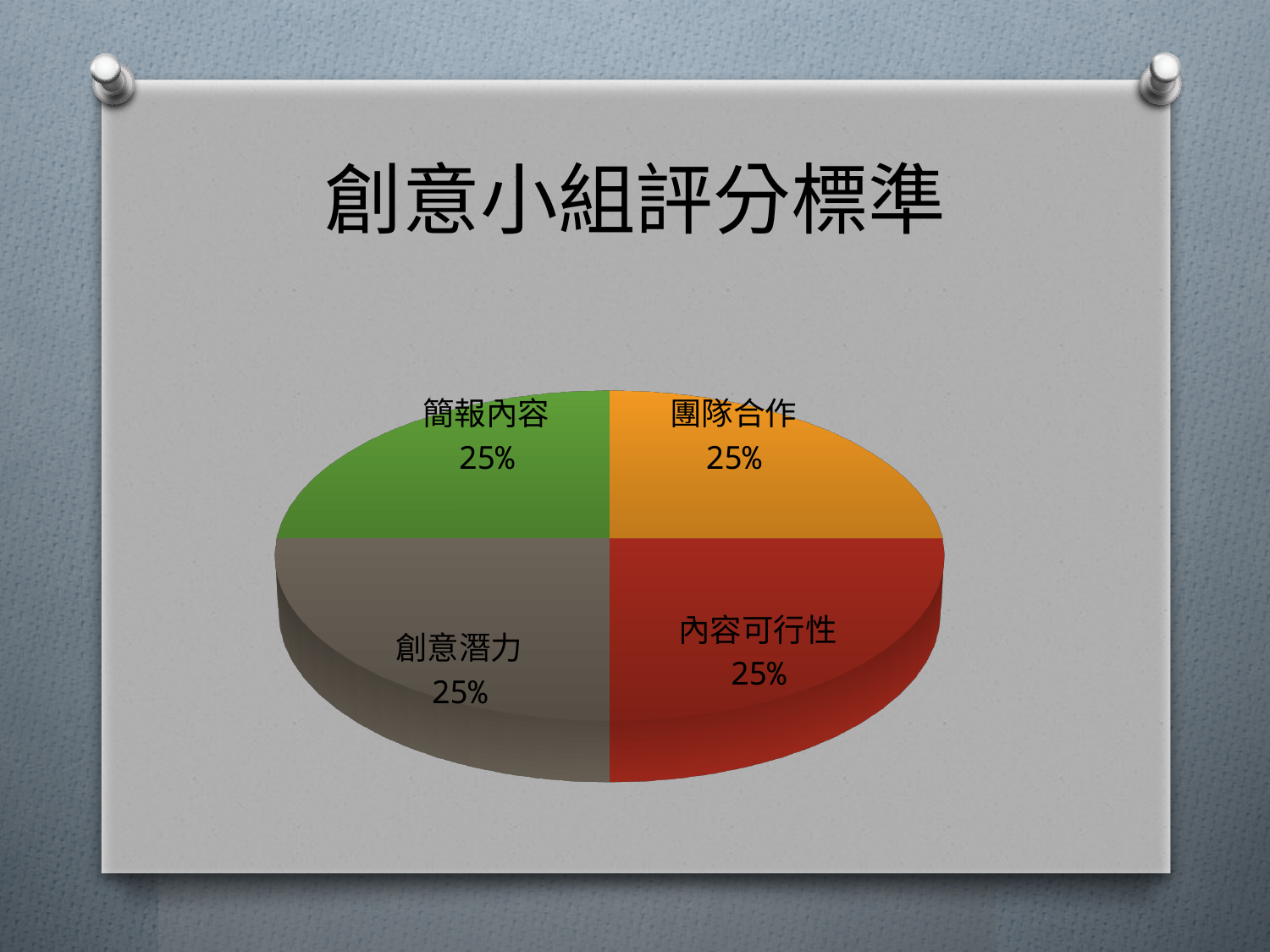
What kind of chart is shown on the slide? pie chart What colour is the slice for 內容可行性? red What is the value shown for 創意潛力? 25% What is the value shown for 團隊合作? 25% What is the value shown for 簡報內容? 25% How many slices does the pie chart have? 4 What is the title of the slide containing the pie chart? 創意小組評分標準 What share of the pie does 創意潛力 represent? 25% What is the value shown for 內容可行性? 25% What is the difference between the values for 團隊合作 and 簡報內容? 0%